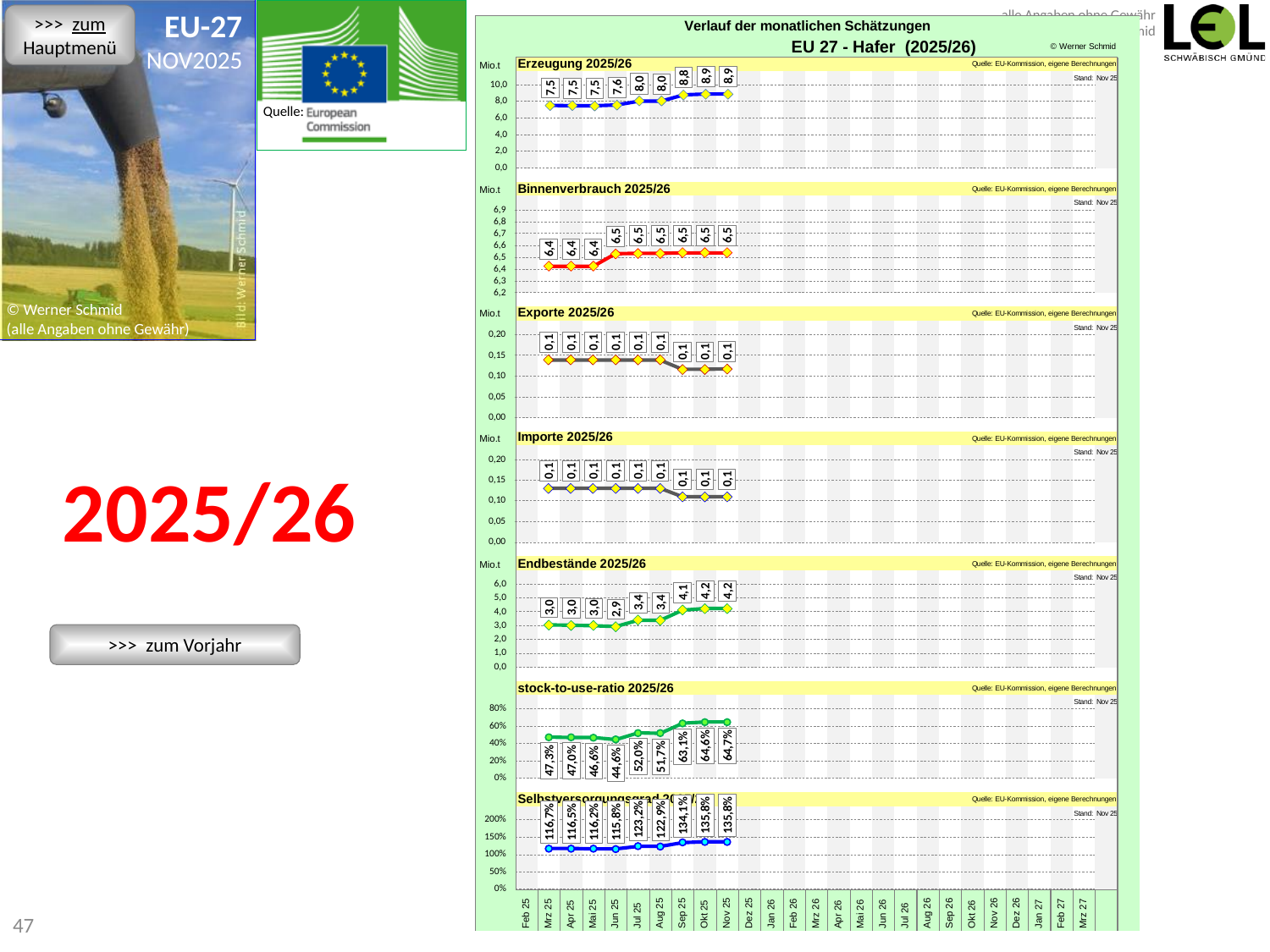
In the Selbstversorgungsgrad chart at the bottom, what is the value for Nov 25? 135,8% In the stock-to-use-ratio 2025/26 chart, what is the value for Nov 25? 64,7% In the Endbestände 2025/26 chart, what is the value for Nov 25? 4,2 In the Erzeugung 2025/26 chart, what is the value for Nov 25? 8,9 In the Erzeugung 2025/26 chart, what is the value for Mrz 25? 7,5 In the stock-to-use-ratio 2025/26 chart, what is the lowest plotted value? 44,6% In the Binnenverbrauch 2025/26 chart, what is the value for Nov 25? 6,5 What kind of chart is the Erzeugung 2025/26 chart? line chart In the Exporte 2025/26 chart, what is the value for Nov 25? 0,1 In the Erzeugung 2025/26 chart, what is the difference between the Nov 25 value and the Mrz 25 value? 1,4 In the Erzeugung 2025/26 chart, do the values rise or fall from Mrz 25 to Nov 25? rise In the Endbestände 2025/26 chart, what is the lowest plotted value? 2,9